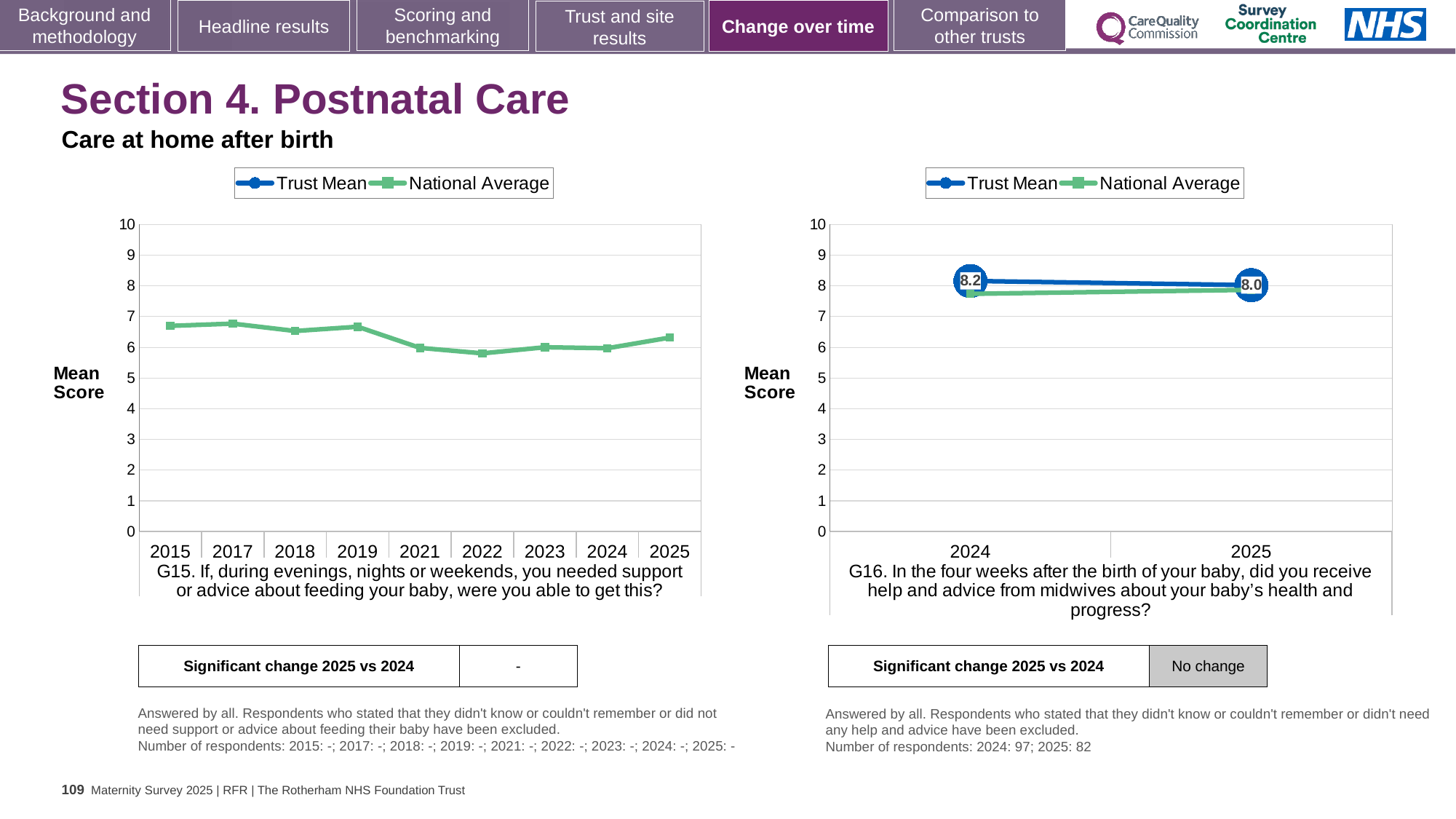
In the right-hand chart (G16), by how much did the Trust Mean change from 2024 to 2025? 0.2 In the right-hand chart (G16), what is the Trust Mean score for 2024? 8.2 In the left-hand chart (G15), is the National Average value for 2022 greater or less than 7? less How many years are shown on the x axis of the left-hand chart (G15)? 9 In the left-hand chart (G15), is the National Average value for 2015 greater or less than 6? greater What are the two series named in the legend of the right-hand chart (G16)? Trust Mean and National Average How many series does the legend of the left-hand chart (G15) list? 2 In the right-hand chart (G16), which is larger in 2024, the Trust Mean or the National Average? Trust Mean In the right-hand chart (G16), does the Trust Mean rise or fall from 2024 to 2025? fall In the right-hand chart (G16), what is the Trust Mean score for 2025? 8.0 How many years are shown on the x axis of the right-hand chart (G16)? 2 What kind of chart is the left-hand chart (G15)? line chart